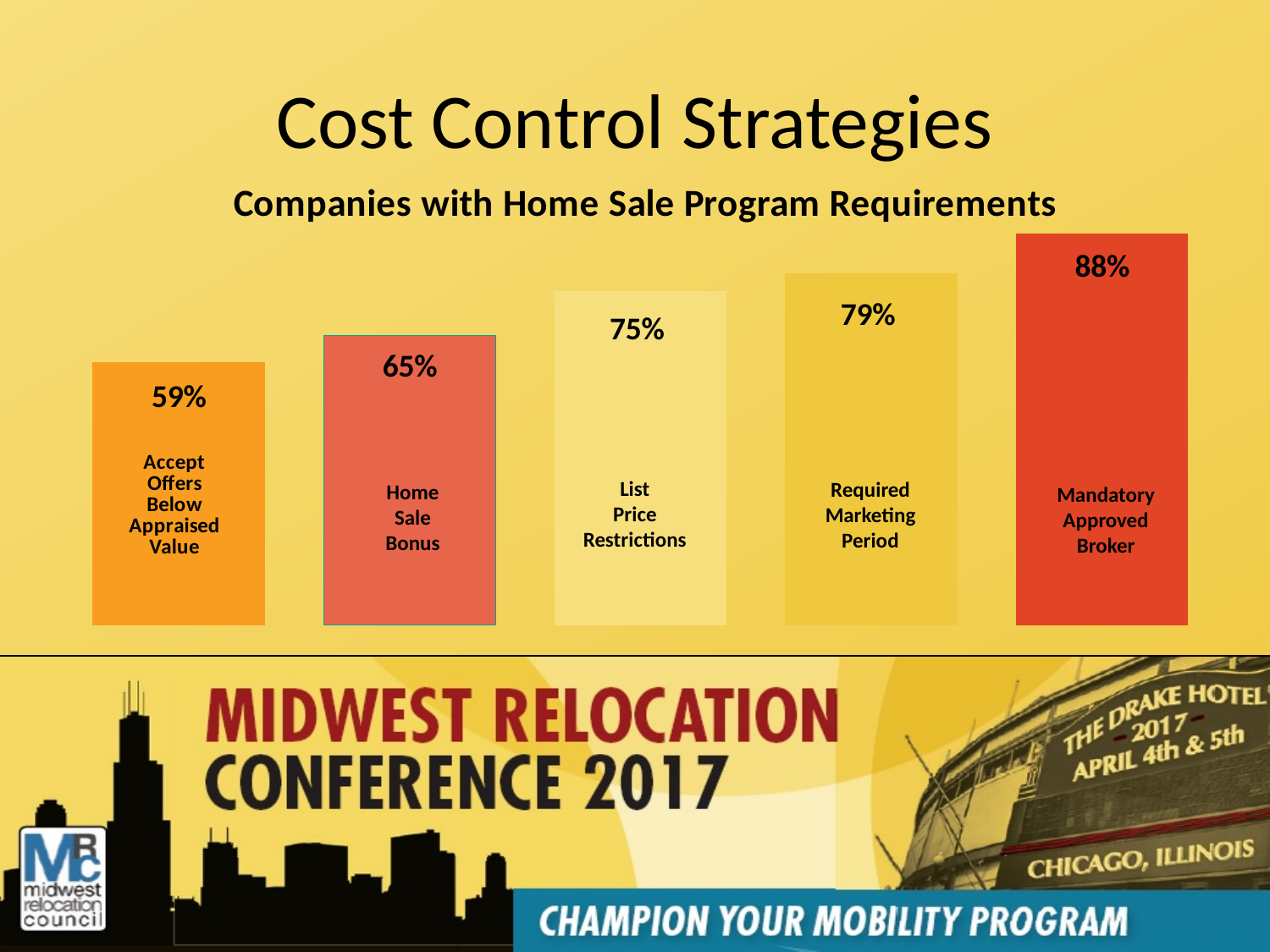
Which is larger, the value for Home Sale Bonus or the value for List Price Restrictions? List Price Restrictions Which home sale program requirement has the highest percentage? Mandatory Approved Broker What is the value shown for Mandatory Approved Broker? 88% How many home sale program requirements are shown in the chart? 5 What is the value shown for Required Marketing Period? 79% What is the difference between the values for Required Marketing Period and List Price Restrictions? 4% What percentage of companies have a Home Sale Bonus requirement? 65% What kind of chart is shown on the slide? Bar chart What is the difference between the values for Mandatory Approved Broker and Accept Offers Below Appraised Value? 29% Which home sale program requirement has the lowest percentage? Accept Offers Below Appraised Value What is the value shown for List Price Restrictions? 75% Do the values rise or fall moving from left to right across the chart? Rise